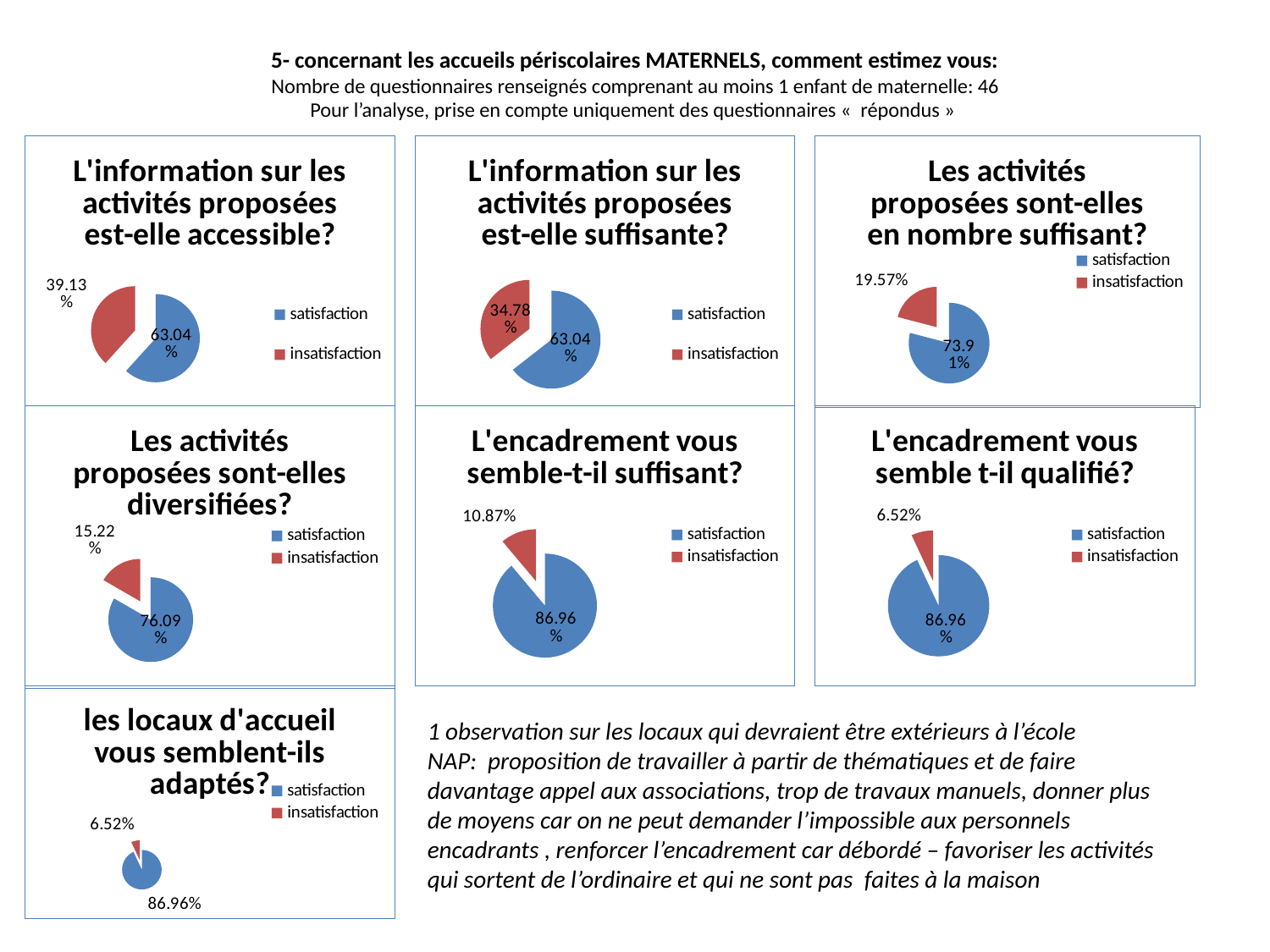
In the chart titled "L'encadrement vous semble t-il qualifié?", which slice is larger, satisfaction or insatisfaction? satisfaction In the chart titled "L'encadrement vous semble-t-il suffisant?", what is the value for insatisfaction? 10.87% In the chart titled "les locaux d'accueil vous semblent-ils adaptés?", what is the value for insatisfaction? 6.52% In the chart titled "L'information sur les activités proposées est-elle accessible?", what is the value for insatisfaction? 39.13% In the chart titled "Les activités proposées sont-elles en nombre suffisant?", what is the value for insatisfaction? 19.57% In the chart titled "L'information sur les activités proposées est-elle accessible?", what is the value for satisfaction? 63.04% How many series does the legend list in the chart titled "Les activités proposées sont-elles diversifiées?"? 2 In the chart titled "Les activités proposées sont-elles diversifiées?", what is the value for satisfaction? 76.09% In the chart titled "L'information sur les activités proposées est-elle suffisante?", what is the difference between the satisfaction and insatisfaction values? 28.26% In the chart titled "L'information sur les activités proposées est-elle suffisante?", what is the value for insatisfaction? 34.78% In the chart titled "Les activités proposées sont-elles en nombre suffisant?", which slice is the smallest? insatisfaction What kind of chart is used in the chart titled "L'encadrement vous semble-t-il suffisant?"? pie chart